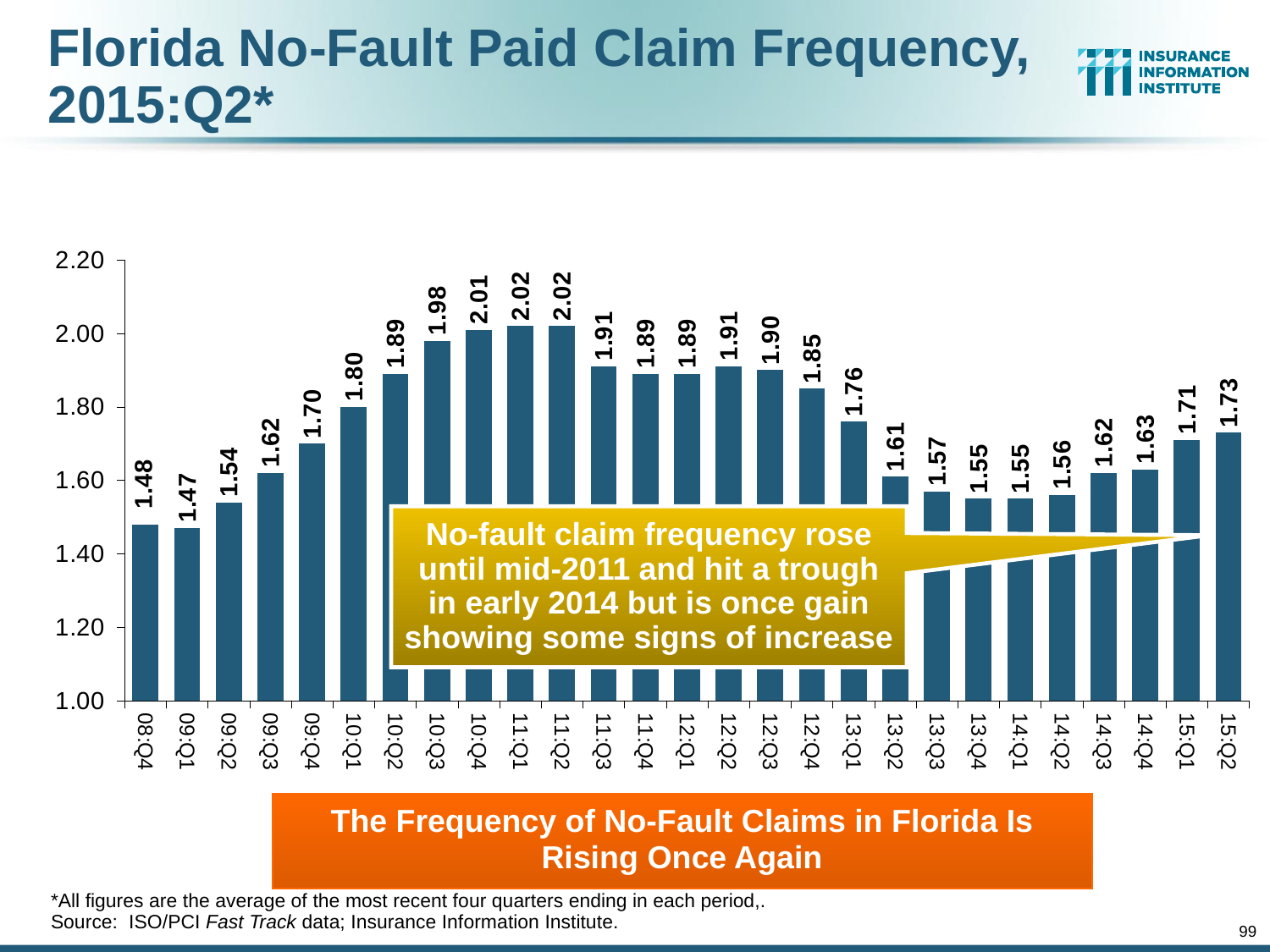
Which period has the lowest paid claim frequency? 09:Q1 What is the value shown for 13:Q2? 1.61 Do the values rise or fall from 08:Q4 to 11:Q2? rise What is the Florida no-fault paid claim frequency for 15:Q2? 1.73 Is the value for 11:Q3 greater or less than 2.00? less What is the title of the chart on the slide? Florida No-Fault Paid Claim Frequency, 2015:Q2* How many quarterly periods are plotted on the chart? 27 Which is larger, the value for 12:Q4 or the value for 13:Q1? 12:Q4 What is the highest paid claim frequency value shown on the chart? 2.02 What is the value shown for 10:Q3? 1.98 What kind of chart is shown on the slide? bar chart What is the difference between the values for 15:Q2 and 13:Q3? 0.16